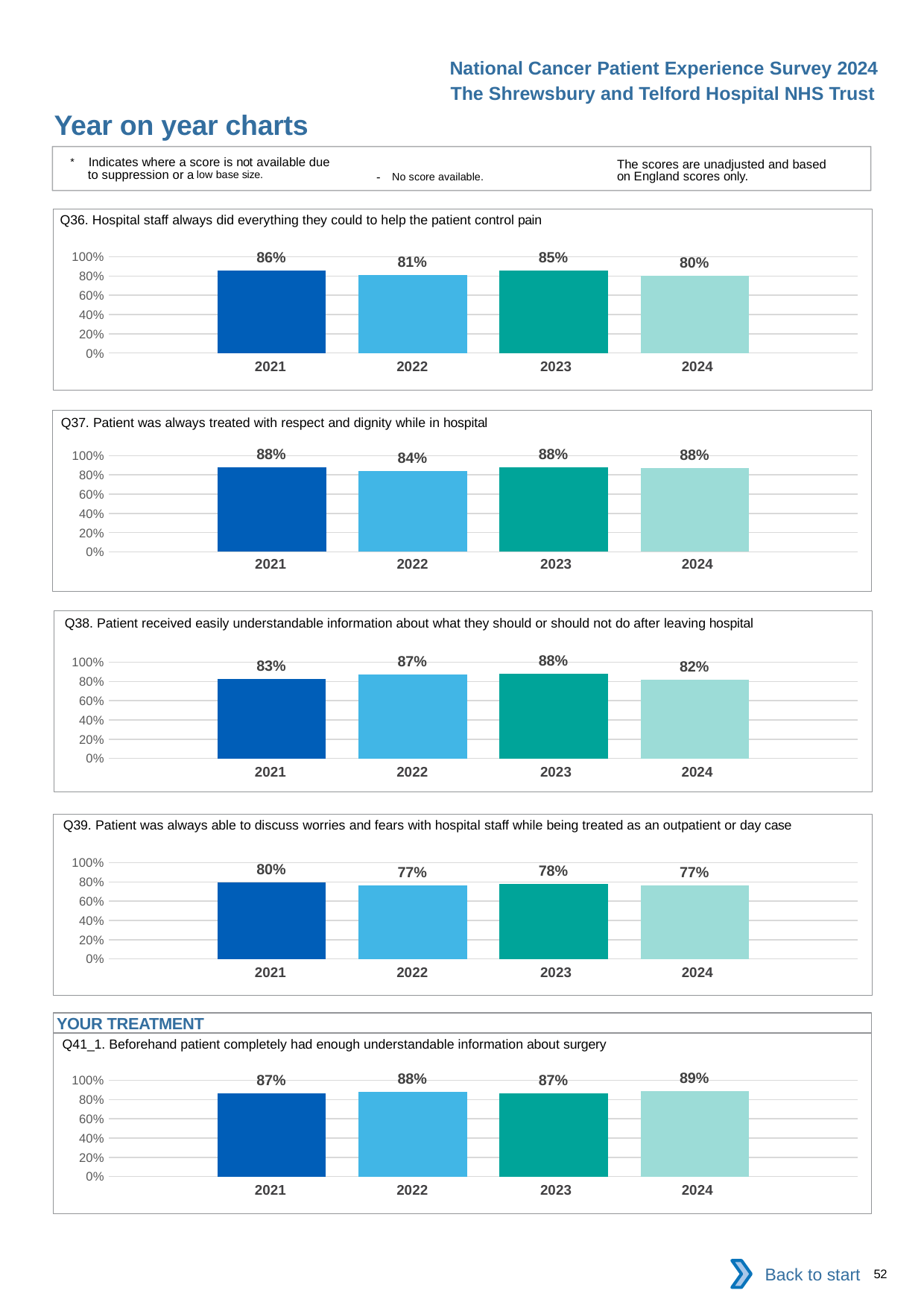
In the Q39 chart (discuss worries and fears as an outpatient), which is larger, the value for 2021 or the value for 2023? 2021 In the Q38 chart (understandable information after leaving hospital), what is the value for 2024? 82% In the Q38 chart (understandable information after leaving hospital), which year has the highest value? 2023 What type of chart is used for Q37 (treated with respect and dignity)? Bar chart In the Q37 chart (treated with respect and dignity), what is the difference between the 2021 and 2022 values? 4 percentage points How many years are shown on the x axis of the Q36 chart? 4 In the Q36 chart (hospital staff helped control pain), what is the value for 2021? 86% In the Q37 chart (treated with respect and dignity), what is the value for 2022? 84% In the Q41_1 chart (understandable information about surgery), what is the difference between the 2024 and 2023 values? 2 percentage points In the Q36 chart (hospital staff helped control pain), which year has the lowest value? 2024 In the Q41_1 chart (understandable information about surgery), which year has the highest value? 2024 In the Q39 chart (discuss worries and fears as an outpatient), what is the value for 2022? 77%